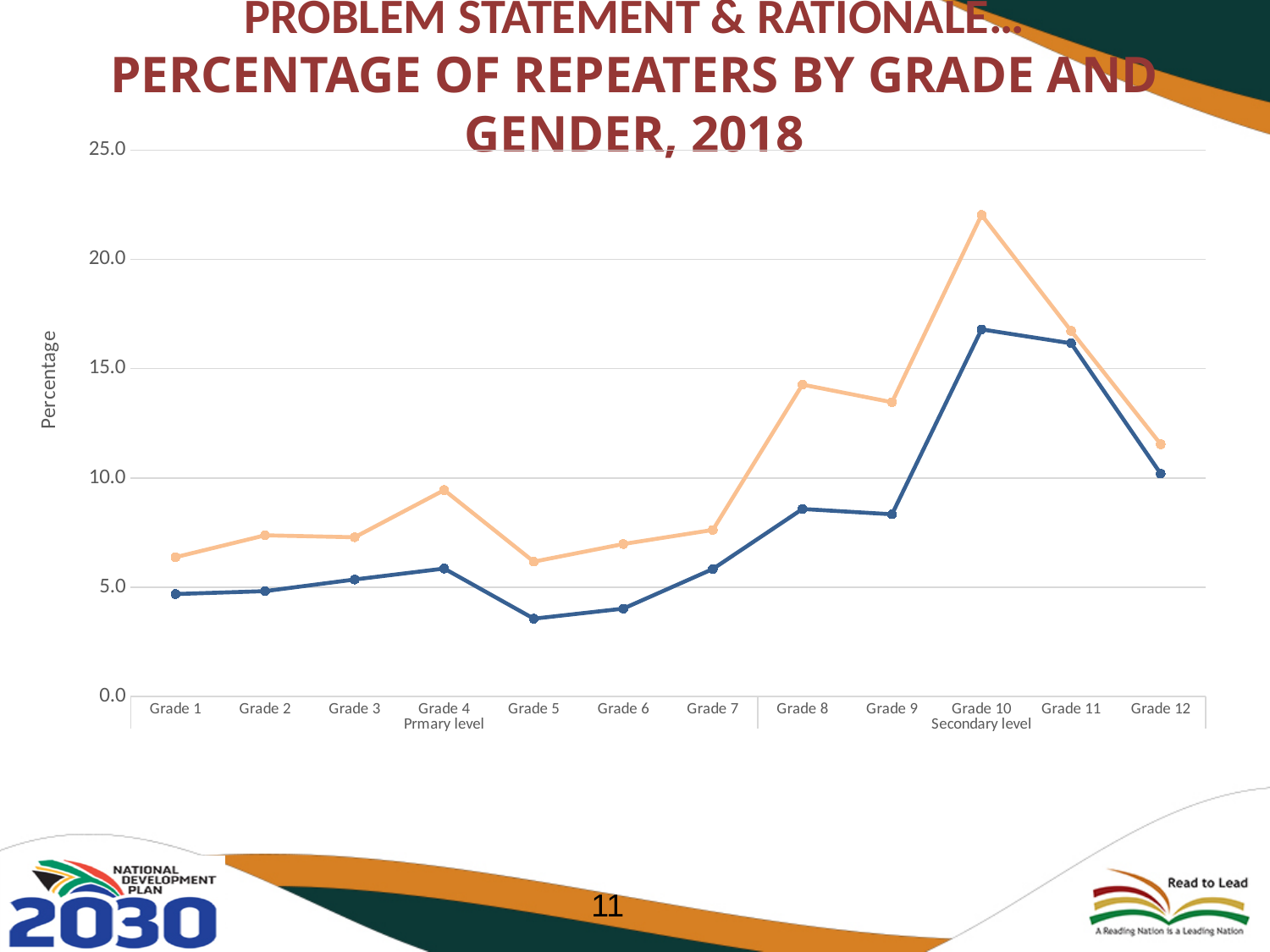
Which grade has the highest value on the blue line? Grade 10 What kind of chart is shown on the slide? Line chart How many lines are plotted on the chart? 2 Is the value for Grade 5 on the blue line greater or less than 5.0? less How many grades are shown along the x axis of the chart? 12 At Grade 10, which line has the larger value, the orange line or the blue line? The orange line Is the value for Grade 4 on the orange line greater or less than 10.0? less Is the value for Grade 10 on the orange line greater or less than 20.0? greater Which grade has the lowest value on the blue line? Grade 5 What is the label on the vertical axis of the chart? Percentage Which grade has the highest value on the orange line? Grade 10 Do the values on both lines rise or fall from Grade 10 to Grade 12? Fall